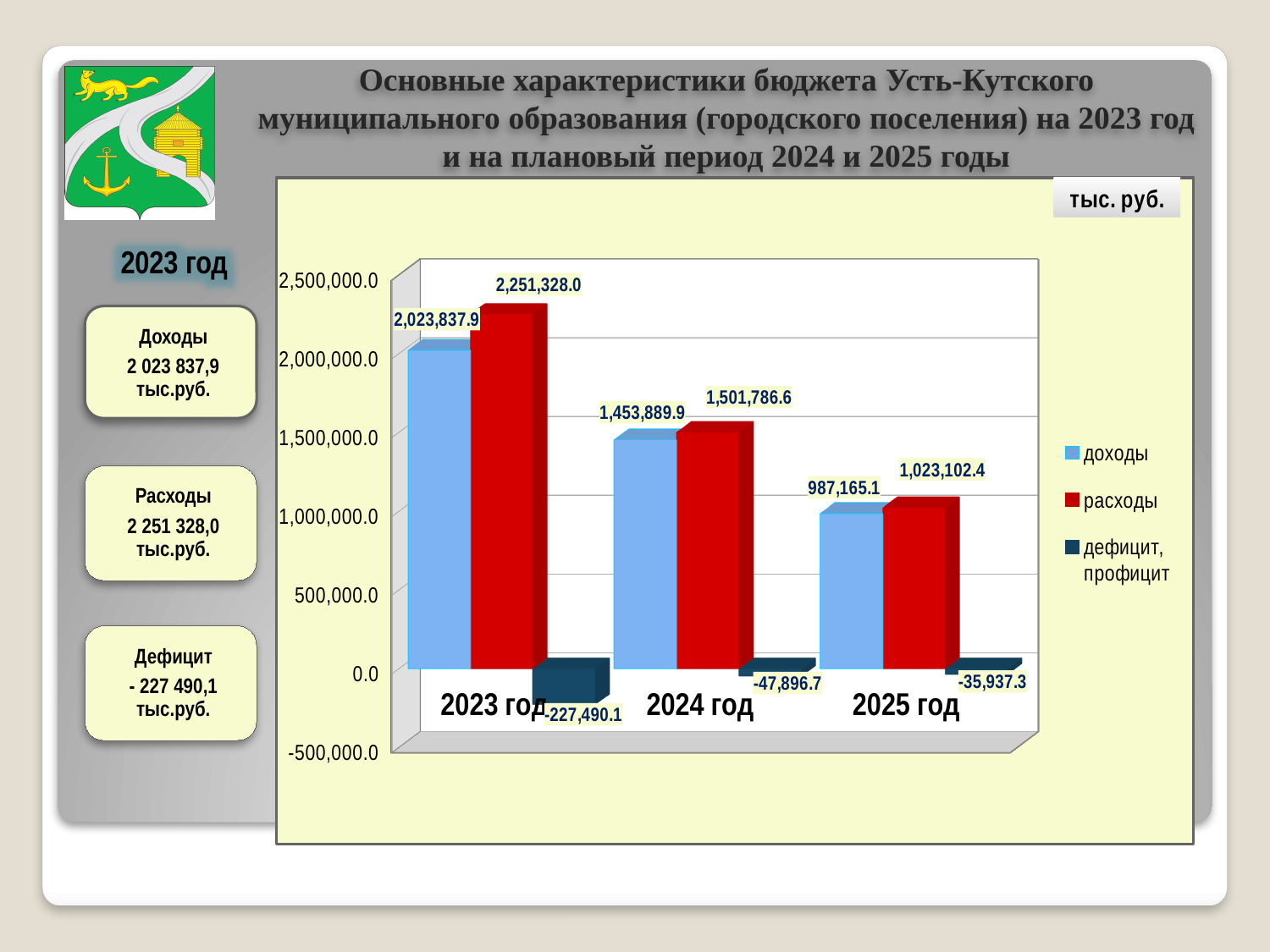
Is the value of доходы for 2024 год greater or less than 1,500,000.0? less What is the difference between расходы and доходы for 2025 год? 35,937.3 How many years are shown on the x axis? 3 How many series does the legend list? 3 What is the value of доходы for 2023 год? 2,023,837.9 Which year has the lowest доходы? 2025 год Which is larger for 2024 год, доходы or расходы? расходы What is the value of дефицит, профицит for 2025 год? -35,937.3 Which year has the highest расходы? 2023 год What kind of chart is shown? bar chart Do the доходы values rise or fall from 2023 год to 2025 год? fall What is the value of расходы for 2024 год? 1,501,786.6